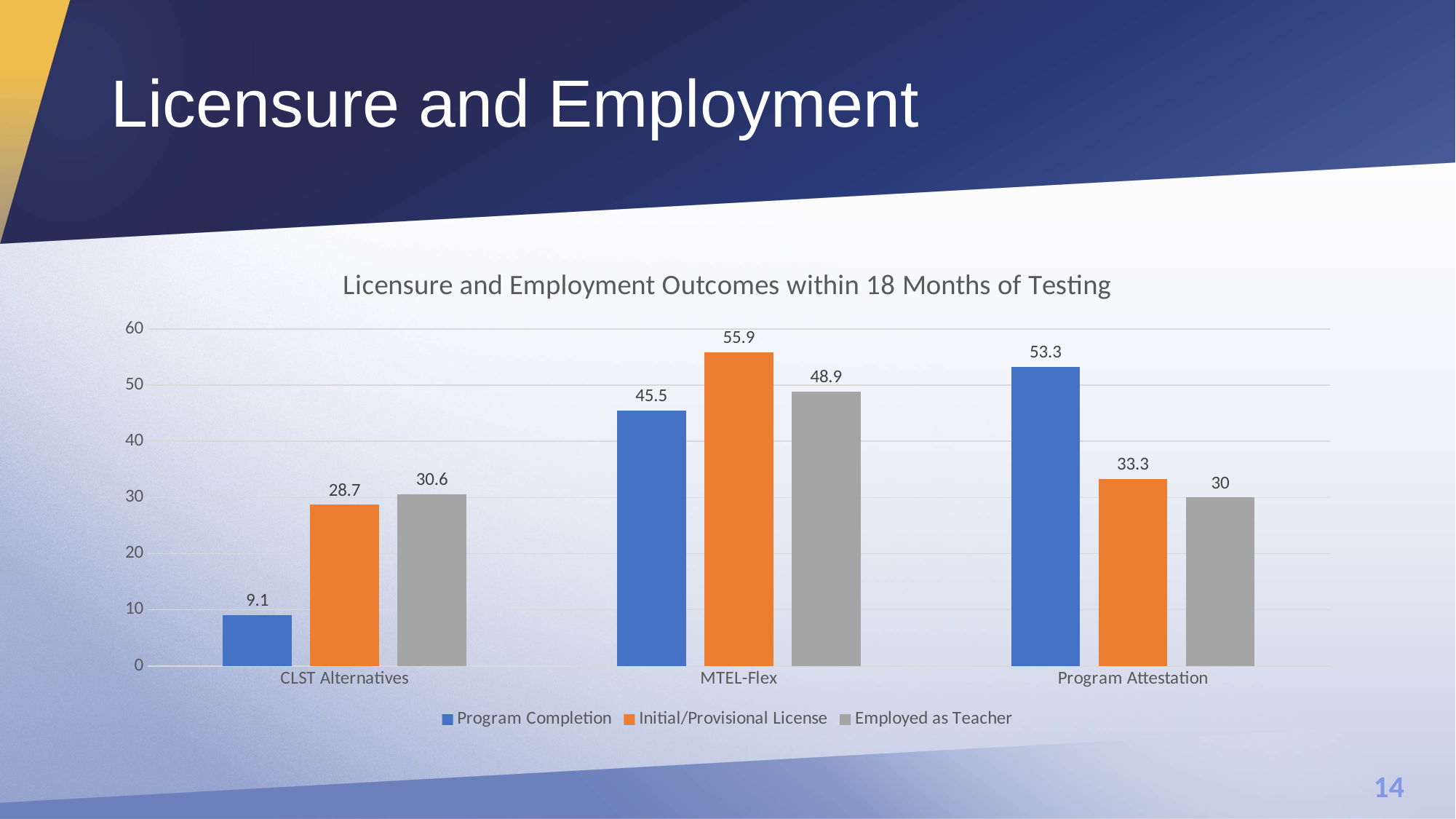
What is the title of the chart? Licensure and Employment Outcomes within 18 Months of Testing Which category has the lowest Employed as Teacher value? Program Attestation What is the difference between the Initial/Provisional License values for MTEL-Flex and Program Attestation? 22.6 What is the Program Completion value for CLST Alternatives? 9.1 How many series does the legend list? 3 Which category has the highest Program Completion value? Program Attestation What is the Initial/Provisional License value for MTEL-Flex? 55.9 What kind of chart is shown on the slide? Bar chart Which is larger for MTEL-Flex: Program Completion or Employed as Teacher? Employed as Teacher What is the Employed as Teacher value for Program Attestation? 30 How many categories are shown on the x axis? 3 Is the Program Completion value for Program Attestation greater or less than 50? greater